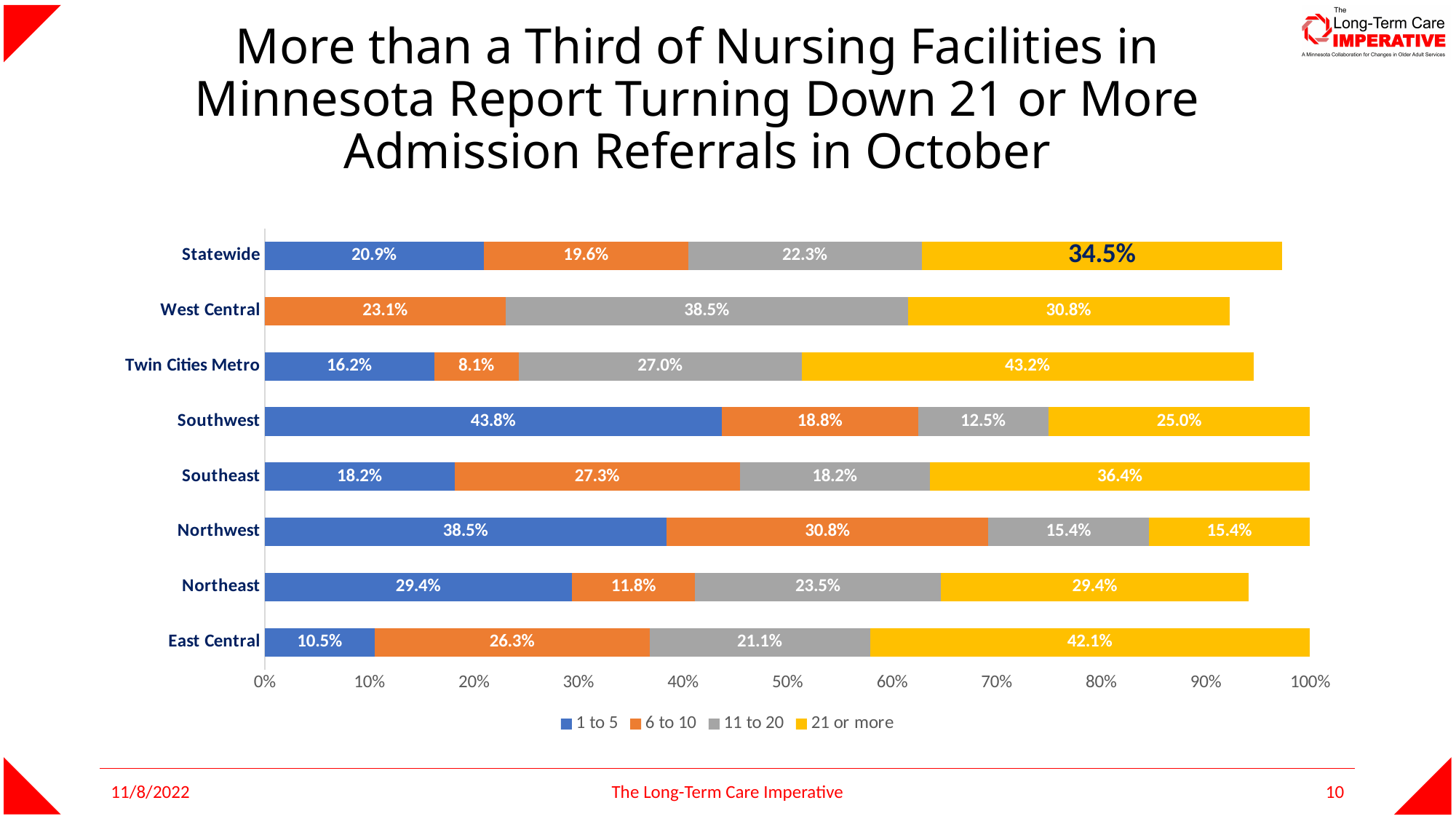
How many series does the legend list? 4 What is the '1 to 5' value for East Central? 10.5% What percentage of Statewide nursing facilities reported turning down 21 or more admission referrals? 34.5% What is the value for the '11 to 20' series for West Central? 38.5% Which is larger for Southeast: the '6 to 10' value or the '21 or more' value? 21 or more What kind of chart is shown on the slide? Stacked bar chart Which region has the highest value for the '1 to 5' series? Southwest How many regions (categories) are shown on the chart? 8 Which region has the highest value for the '21 or more' series? Twin Cities Metro What is the '6 to 10' value for Twin Cities Metro? 8.1% Which region has the lowest value for the '21 or more' series? Northwest What is the difference between the '21 or more' and '1 to 5' values for Statewide? 13.6%